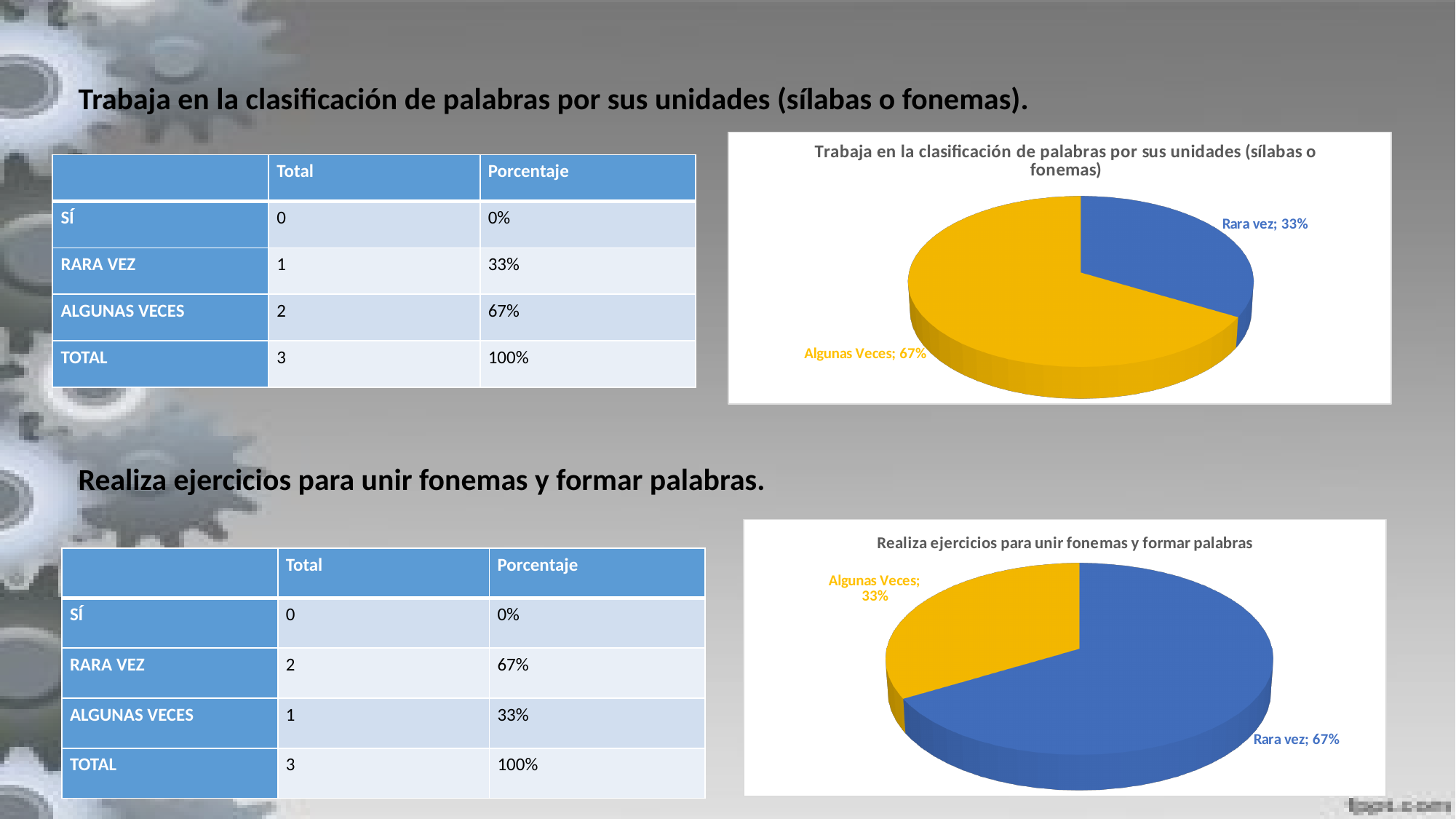
In the bottom chart 'Realiza ejercicios para unir fonemas y formar palabras', what percentage is shown for Rara vez? 67% In the top chart 'Trabaja en la clasificación de palabras por sus unidades (sílabas o fonemas)', which slice is the largest? Algunas Veces In the top chart 'Trabaja en la clasificación de palabras por sus unidades (sílabas o fonemas)', what percentage is shown for Algunas Veces? 67% In the bottom chart 'Realiza ejercicios para unir fonemas y formar palabras', what percentage is shown for Algunas Veces? 33% What kind of chart is the top chart 'Trabaja en la clasificación de palabras por sus unidades (sílabas o fonemas)'? Pie chart In the top chart 'Trabaja en la clasificación de palabras por sus unidades (sílabas o fonemas)', what is the difference in percentage points between Algunas Veces and Rara vez? 34 In the bottom chart 'Realiza ejercicios para unir fonemas y formar palabras', which is larger, Rara vez or Algunas Veces? Rara vez What is the title of the bottom chart on the slide? Realiza ejercicios para unir fonemas y formar palabras In the top chart 'Trabaja en la clasificación de palabras por sus unidades (sílabas o fonemas)', what percentage is shown for Rara vez? 33% In the bottom chart 'Realiza ejercicios para unir fonemas y formar palabras', which slice is the smallest? Algunas Veces How many slices does the top chart 'Trabaja en la clasificación de palabras por sus unidades (sílabas o fonemas)' show? 2 In the bottom chart 'Realiza ejercicios para unir fonemas y formar palabras', what colour is the Rara vez slice? Blue